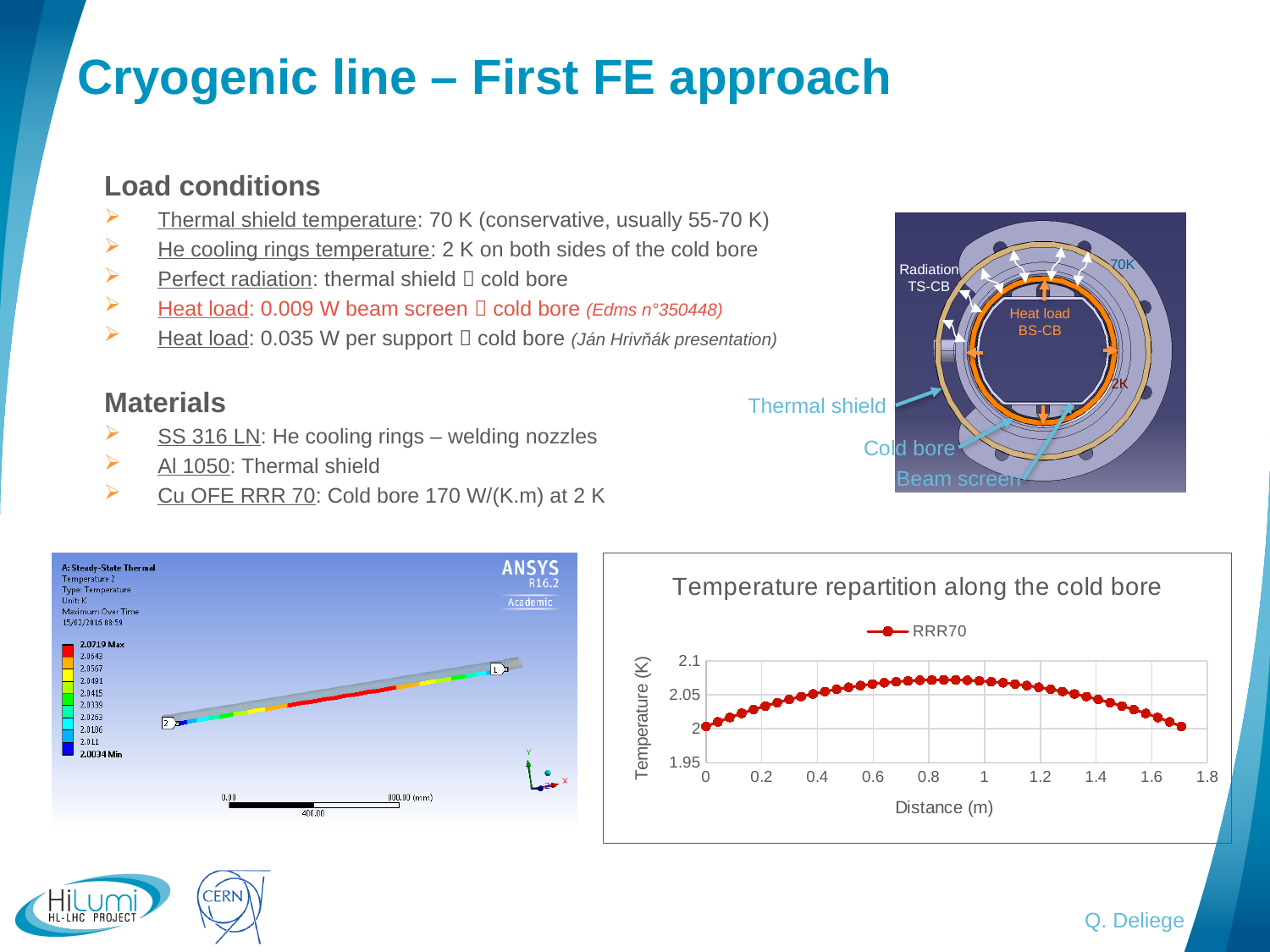
In the "Temperature repartition along the cold bore" chart, is the temperature at a distance of 0.2 m greater or less than 2.05 K? less What is the name of the series shown in the legend of the "Temperature repartition along the cold bore" chart? RRR70 What kind of chart is "Temperature repartition along the cold bore"? line chart In the "Temperature repartition along the cold bore" chart, how does the temperature change as the distance increases from 0 to about 1.7 m? It rises to a peak near the middle and then falls In the "Temperature repartition along the cold bore" chart, is the temperature at a distance of 1.6 m greater or less than 2.05 K? less In the "Temperature repartition along the cold bore" chart, is the temperature higher at a distance of 1.0 m or at 1.6 m? 1.0 m In the "Temperature repartition along the cold bore" chart, is the temperature higher at a distance of 0.8 m or at 0 m? 0.8 m In the "Temperature repartition along the cold bore" chart, does the temperature rise or fall between a distance of 1.2 m and 1.6 m? fall In the "Temperature repartition along the cold bore" chart, is the temperature at a distance of 0.8 m greater or less than 2.05 K? greater What is the label of the x axis of the "Temperature repartition along the cold bore" chart? Distance (m) How many series does the legend of the "Temperature repartition along the cold bore" chart list? 1